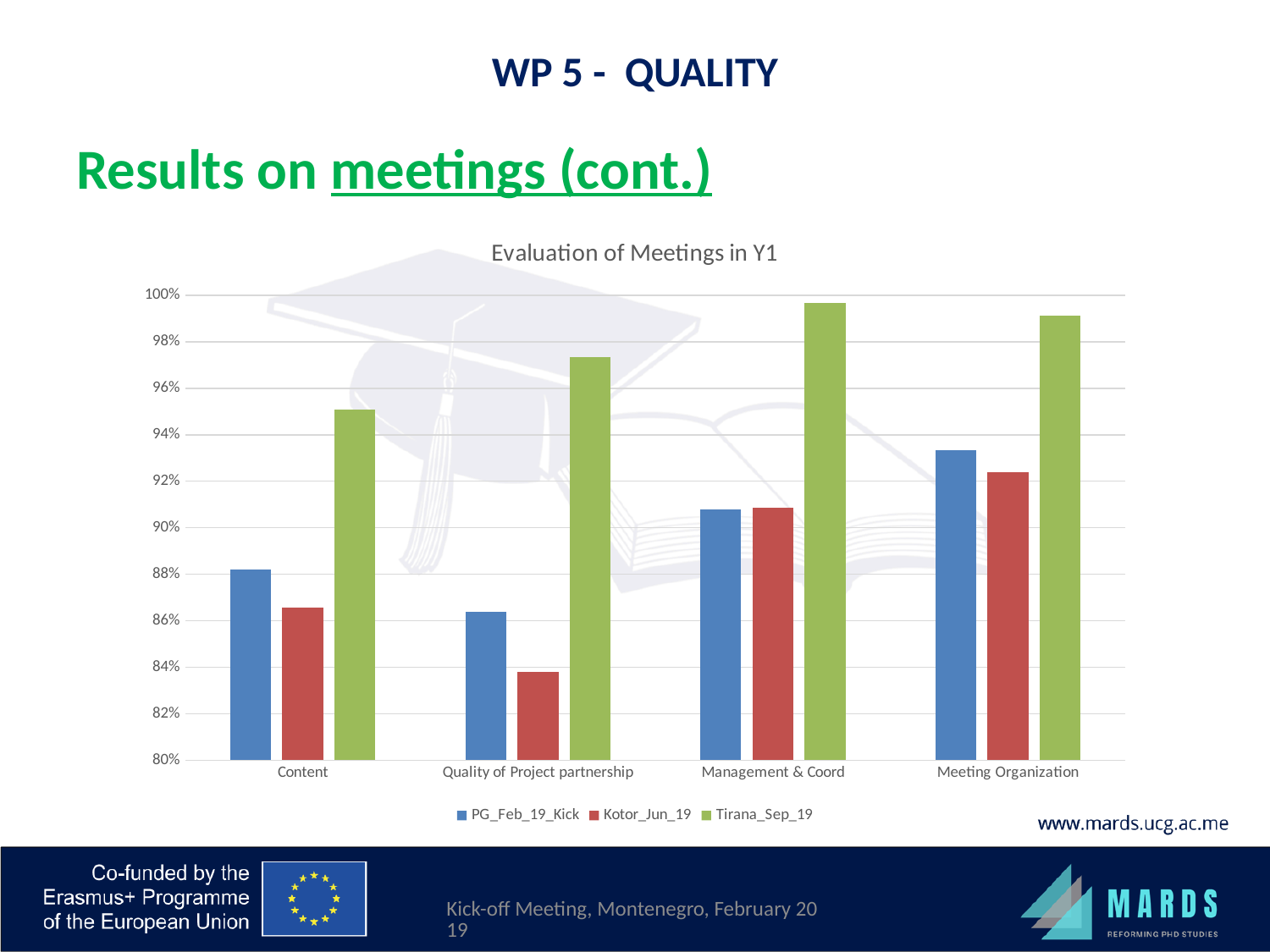
Is the Kotor_Jun_19 value for Quality of Project partnership greater or less than 86%? less Is the Tirana_Sep_19 value for Content greater or less than 94%? greater Which category has the lowest Kotor_Jun_19 value? Quality of Project partnership What is the title of the chart? Evaluation of Meetings in Y1 Which category has the highest PG_Feb_19_Kick value? Meeting Organization Is the Tirana_Sep_19 value for Management & Coord greater or less than 98%? greater How many series does the legend list? 3 For Content, which is larger: the PG_Feb_19_Kick value or the Kotor_Jun_19 value? PG_Feb_19_Kick Which colour represents the Tirana_Sep_19 series? Green How many categories are shown on the x axis? 4 Which series has the highest value in every category? Tirana_Sep_19 What kind of chart is shown on the slide? Bar chart